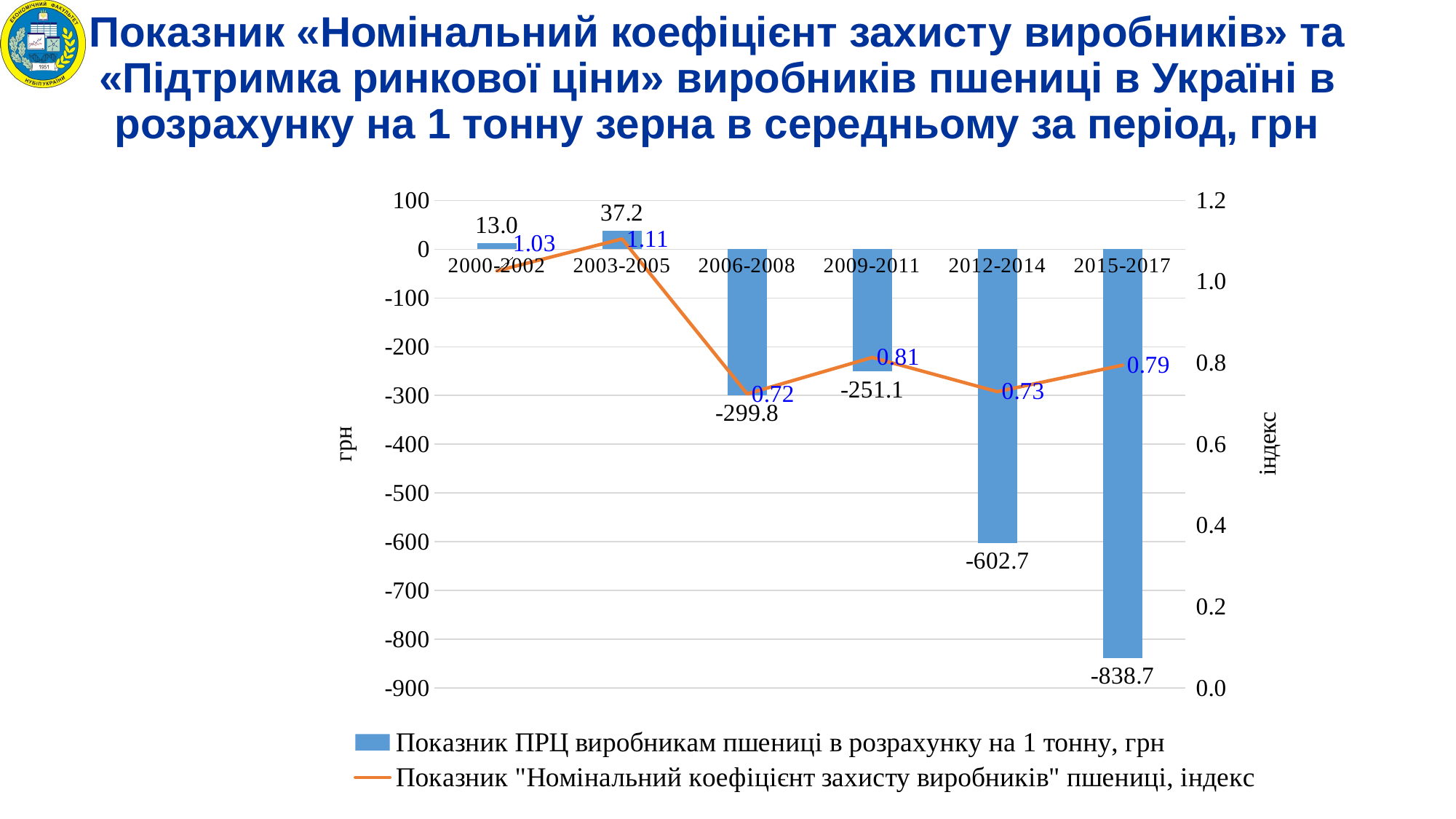
How many series does the legend list? 2 How many periods are shown on the x axis? 6 In which period is the bar series (ПРЦ, грн) highest? 2003-2005 In which period is the index (line series) lowest? 2006-2008 What is the value of the line series (Номінальний коефіцієнт захисту виробників, індекс) for 2003-2005? 1.11 What is the label of the right-hand vertical axis? індекс What is the value of the bar series for 2006-2008? -299.8 What is the index value (line series) for 2012-2014? 0.73 Which period has a larger index value, 2009-2011 or 2015-2017? 2009-2011 What is the value of the bar series (Показник ПРЦ виробникам пшениці в розрахунку на 1 тонну, грн) for 2015-2017? -838.7 What is the difference between the bar values for 2012-2014 and 2015-2017? 236.0 What kind of chart is shown on the slide? Combined bar and line chart